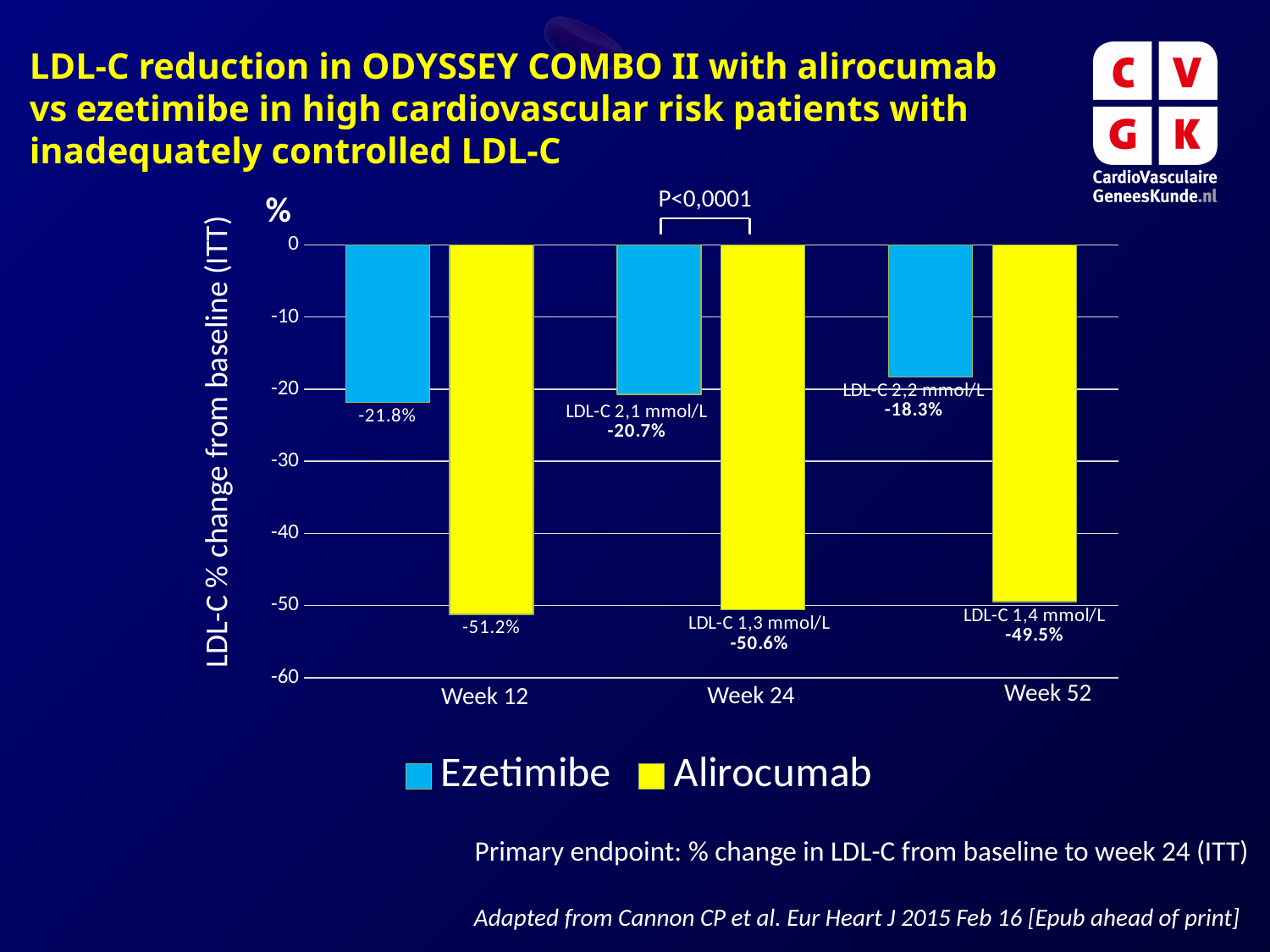
At which week does Alirocumab show its largest LDL-C reduction? Week 12 How many time points (categories) are shown on the x axis? 3 What is the difference between the Alirocumab and Ezetimibe LDL-C % change at Week 24? 29.9 percentage points What is the LDL-C % change from baseline for Alirocumab at Week 24? -50.6% At which week does Ezetimibe show its smallest LDL-C reduction? Week 52 Which treatment shows a larger LDL-C reduction at Week 12, Ezetimibe or Alirocumab? Alirocumab How many series does the legend list? 2 What is the LDL-C % change from baseline for Alirocumab at Week 52? -49.5% What is the LDL-C % change from baseline for Ezetimibe at Week 52? -18.3% What kind of chart is shown on the slide? Bar chart What P value is shown above the Week 24 bars? P<0,0001 What is the LDL-C % change from baseline for Ezetimibe at Week 12? -21.8%